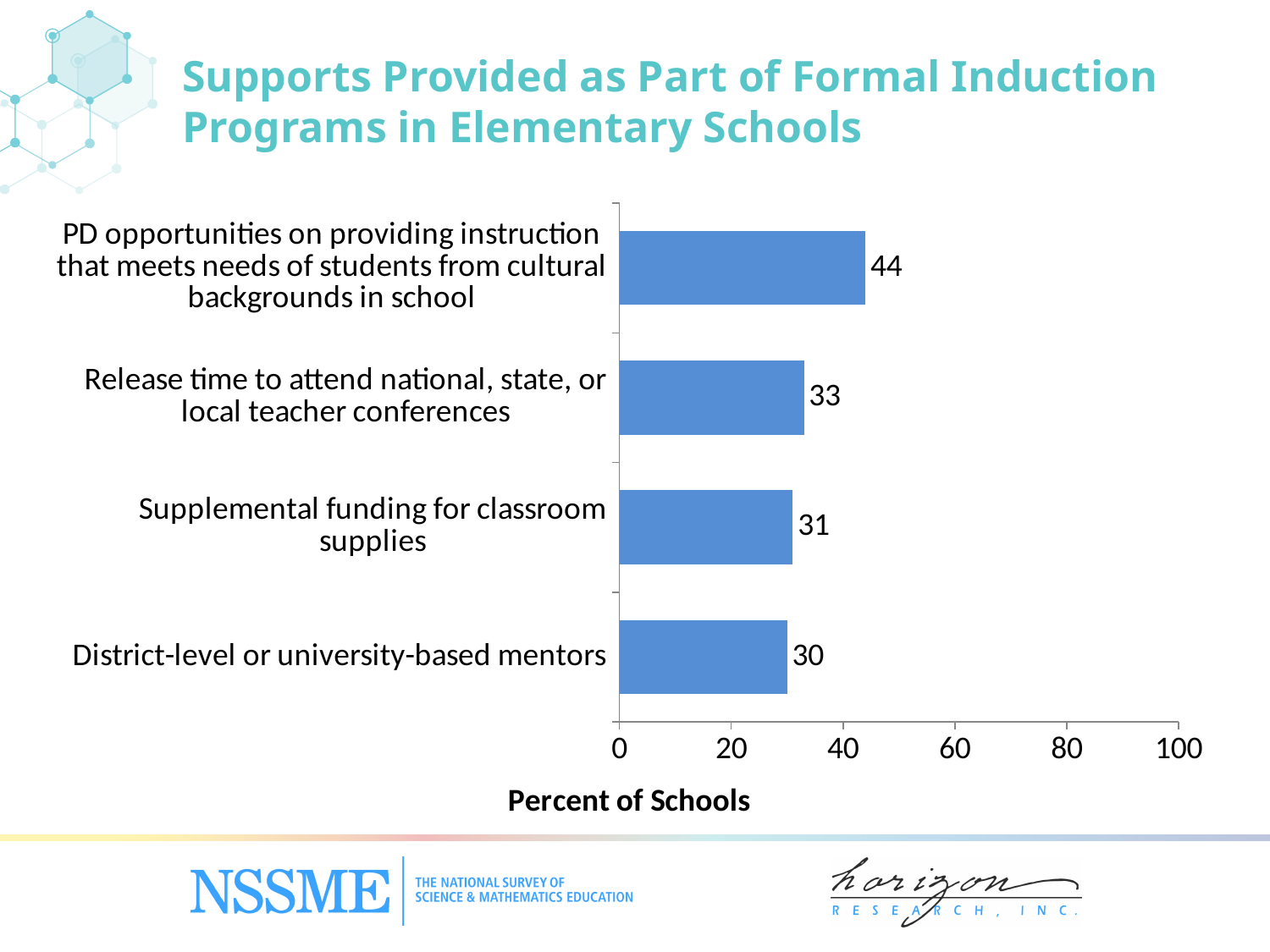
What percent of schools provide release time to attend national, state, or local teacher conferences? 33 What is the label of the horizontal axis? Percent of Schools What kind of chart is shown on the slide? Bar chart Which support has the lowest percent of schools? District-level or university-based mentors Which support has the highest percent of schools? PD opportunities on providing instruction that meets needs of students from cultural backgrounds in school How many supports are shown in the chart? 4 What is the difference between the value for PD opportunities on providing instruction that meets needs of students from cultural backgrounds and the value for district-level or university-based mentors? 14 What is the value for PD opportunities on providing instruction that meets needs of students from cultural backgrounds in school? 44 Is the value for PD opportunities on providing instruction that meets needs of students from cultural backgrounds greater or less than 40? greater Which is larger: the value for release time to attend teacher conferences or the value for supplemental funding for classroom supplies? Release time to attend national, state, or local teacher conferences What percent of schools provide district-level or university-based mentors? 30 What is the value for supplemental funding for classroom supplies? 31